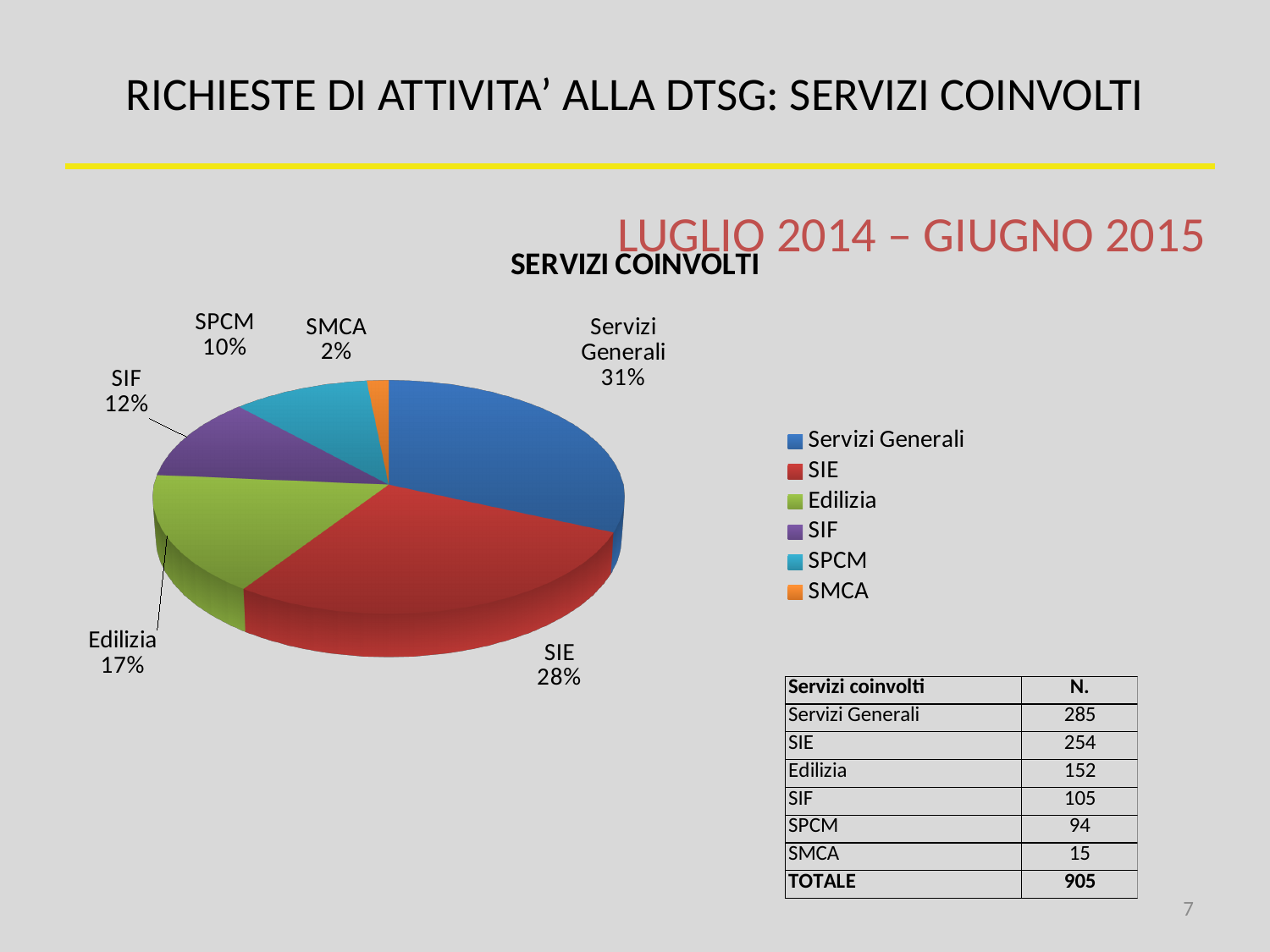
Which category has the largest slice of the pie chart? Servizi Generali What is the difference in percentage points between the Servizi Generali slice and the SIE slice? 3% Which category has the smallest slice of the pie chart? SMCA What percentage share does Servizi Generali have in the pie chart? 31% What percentage share does SPCM have in the pie chart? 10% What kind of chart is shown on the slide? pie chart How many slices does the pie chart have? 6 Which slice is larger, Edilizia or SIF? Edilizia What percentage share does SIF have in the pie chart? 12% What is the chart's title? SERVIZI COINVOLTI